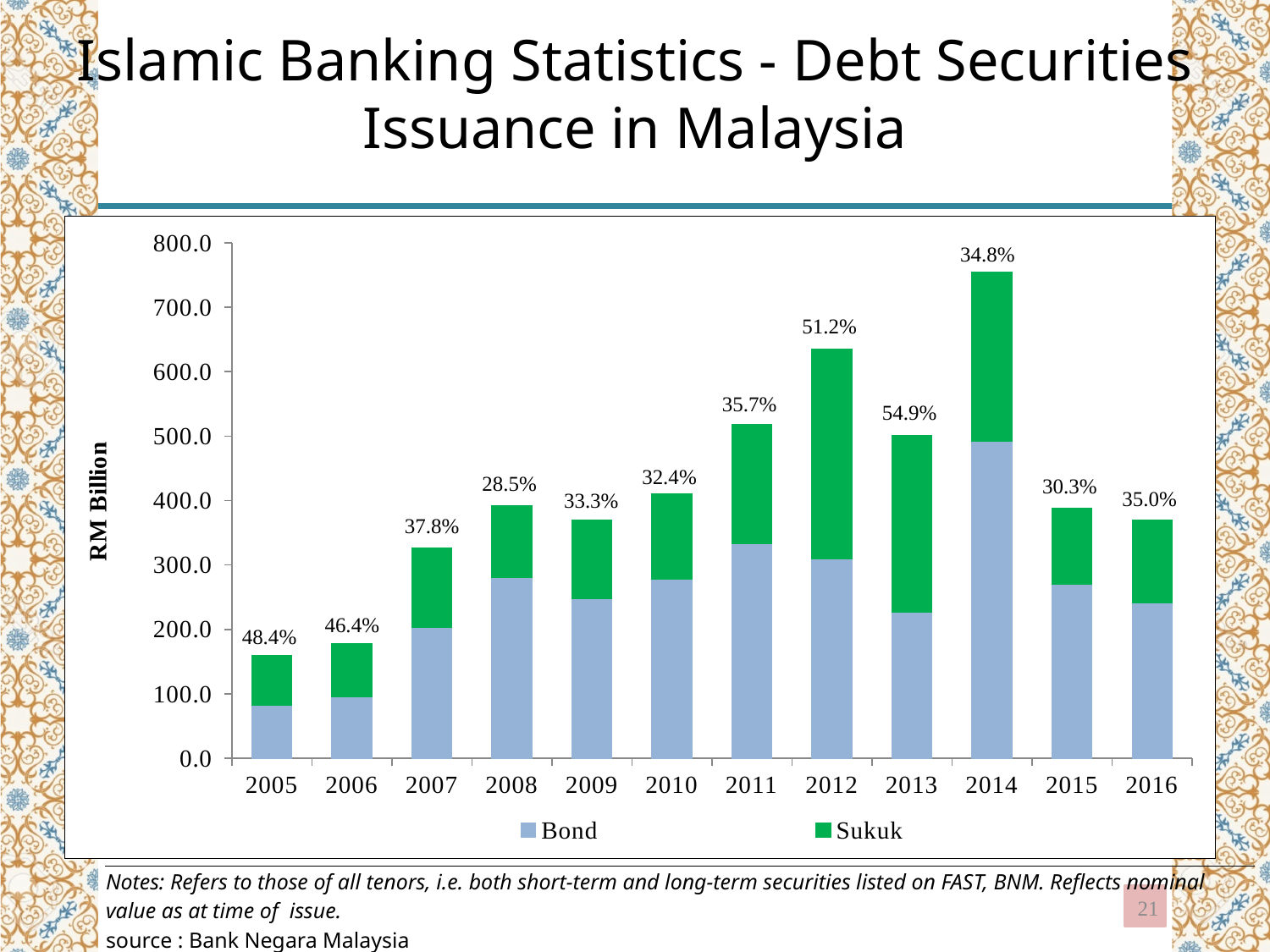
Is the Bond value for 2005 greater or less than 100.0 RM Billion? less Which year has the tallest stacked bar (highest total issuance)? 2014 Which year has the lowest percentage label shown above its bar? 2008 Which year has the shortest stacked bar (lowest total issuance)? 2005 How many years are shown on the x axis? 12 Is the total bar height for 2014 greater or less than 700.0 RM Billion? greater What percentage label is shown above the bar for 2005? 48.4% How many series does the legend list? 2 What percentage label is shown above the bar for 2013? 54.9% Which year has the highest percentage label shown above its bar? 2013 Which year has a taller total bar, 2012 or 2013? 2012 What percentage label is shown above the bar for 2016? 35.0%